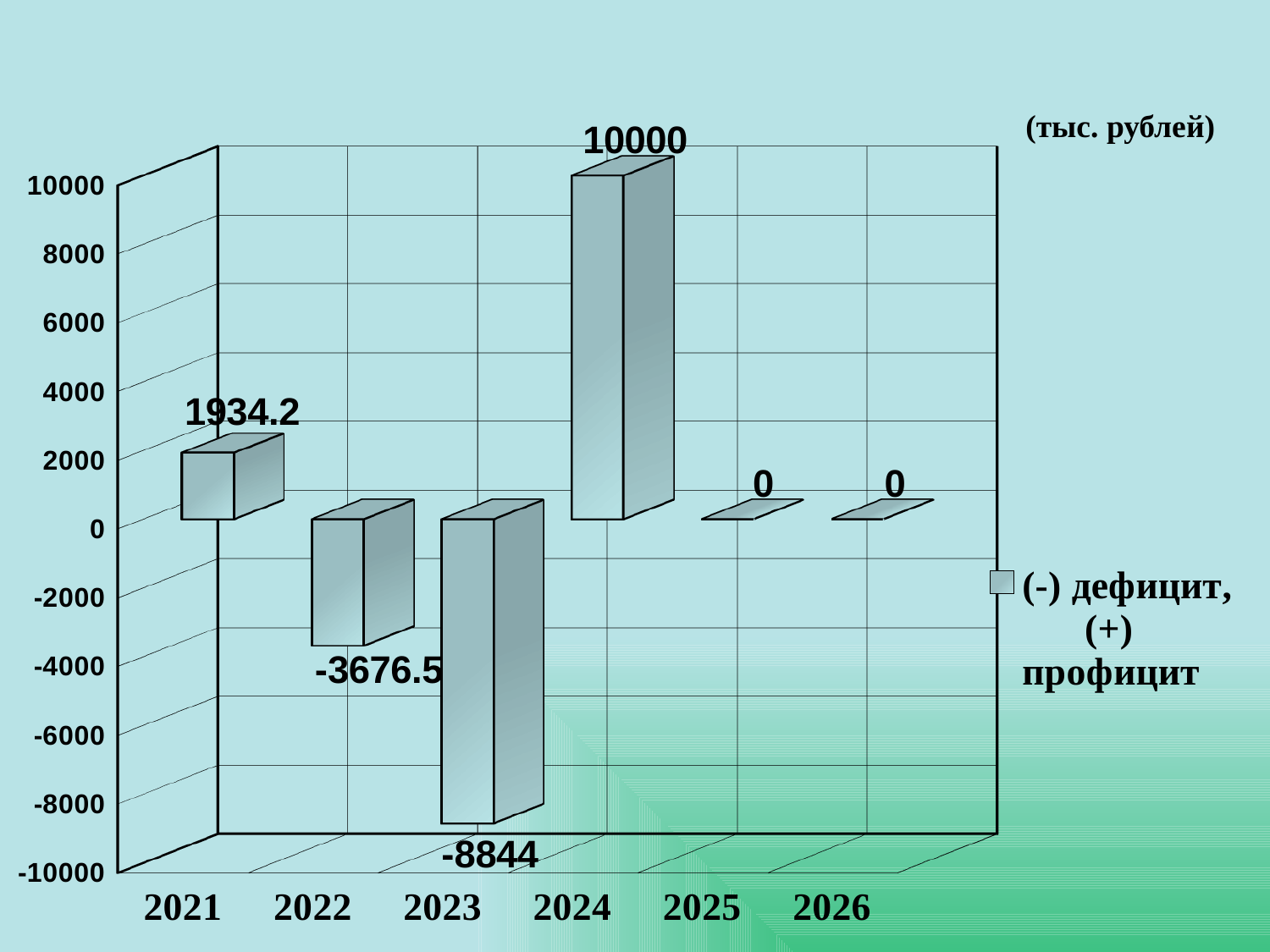
What is the value for 2024? 10000 Which is larger, the value for 2022 or the value for 2023? 2022 What kind of chart is shown on the slide? bar chart Which year has the lowest value? 2023 What unit is indicated in the top right corner of the chart? (тыс. рублей) What is the value for 2021? 1934.2 Which year has the highest value? 2024 How many years are shown on the x axis? 6 What is the value for 2025? 0 What is the difference between the values for 2024 and 2021? 8065.8 What is the value for 2022? -3676.5 What is the value for 2023? -8844